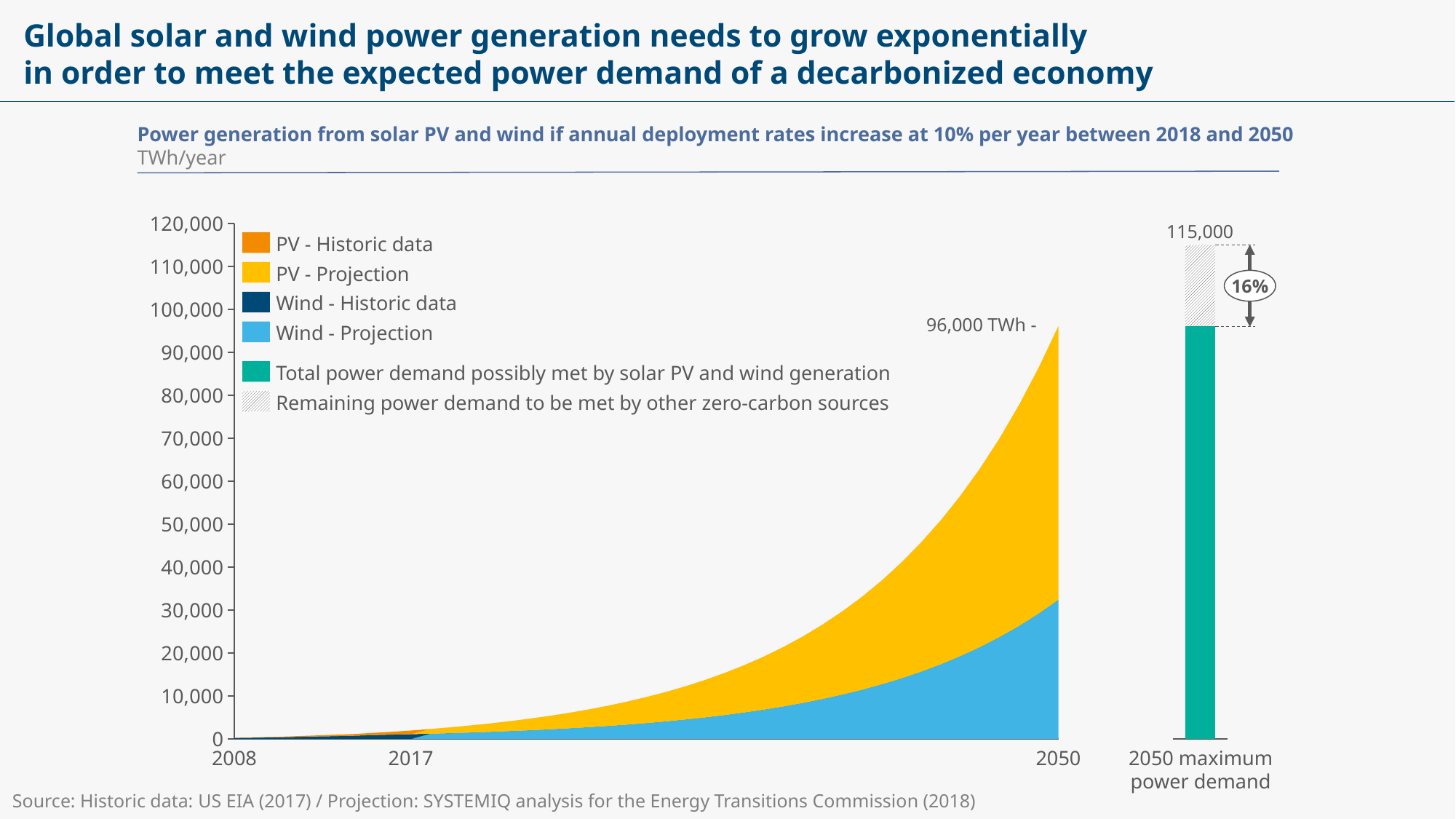
What percentage of the 2050 maximum power demand remains to be met by other zero-carbon sources? 16% Is the Wind - Projection value in 2050 greater or less than 40,000? less What kind of chart is used to show solar PV and wind generation from 2008 to 2050? Area chart What is the total power generation from solar PV and wind in 2050 shown on the chart? 96,000 TWh What unit is used on the chart's y axis? TWh/year What is the first year shown on the chart's x axis? 2008 Is the combined solar PV and wind generation in 2050 greater or less than 90,000? greater What is the 2050 maximum power demand shown on the chart? 115,000 In 2050, which is larger: PV - Projection or Wind - Projection? PV - Projection What is the difference between the 2050 maximum power demand (115,000) and the 96,000 TWh generated by solar PV and wind? 19,000 Does solar PV and wind power generation rise or fall between 2008 and 2050? Rise How many entries does the chart legend list? 6